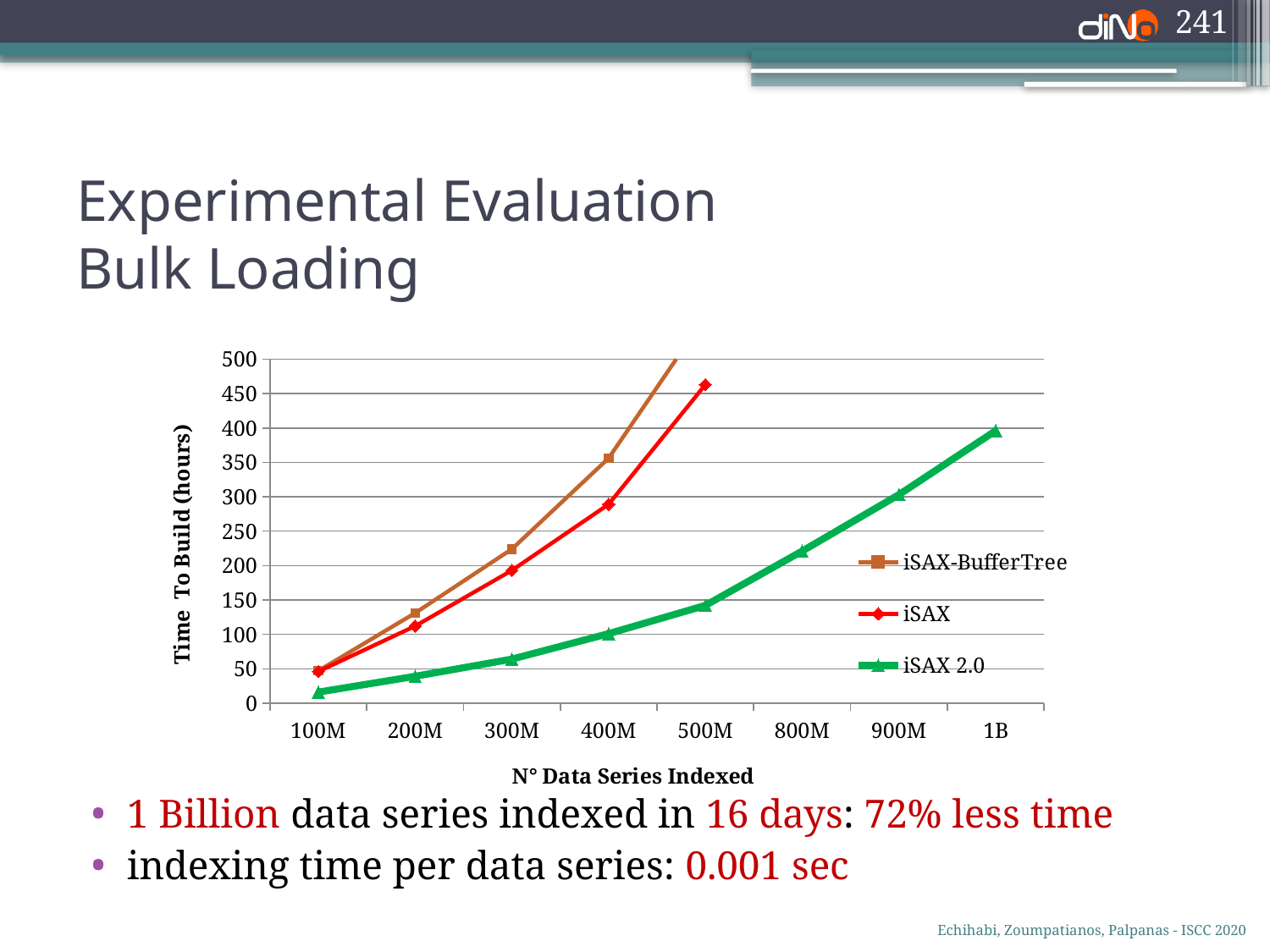
What is the title of the chart's x axis? N° Data Series Indexed How many series does the chart's legend list? 3 What is the title of the chart's y axis? Time To Build (hours) Is the value for iSAX-BufferTree at 200M greater or less than 100? greater Does the iSAX 2.0 line rise or fall as the number of data series indexed increases? rises What kind of chart is shown on the slide? line chart How many points are labelled along the x axis of the chart? 8 Is the value for iSAX at 500M greater or less than 400? greater Which series has the lowest value at 100M? iSAX 2.0 Is the value for iSAX 2.0 at 500M greater or less than 200? less At 400M, which is larger: the value for iSAX-BufferTree or the value for iSAX? iSAX-BufferTree